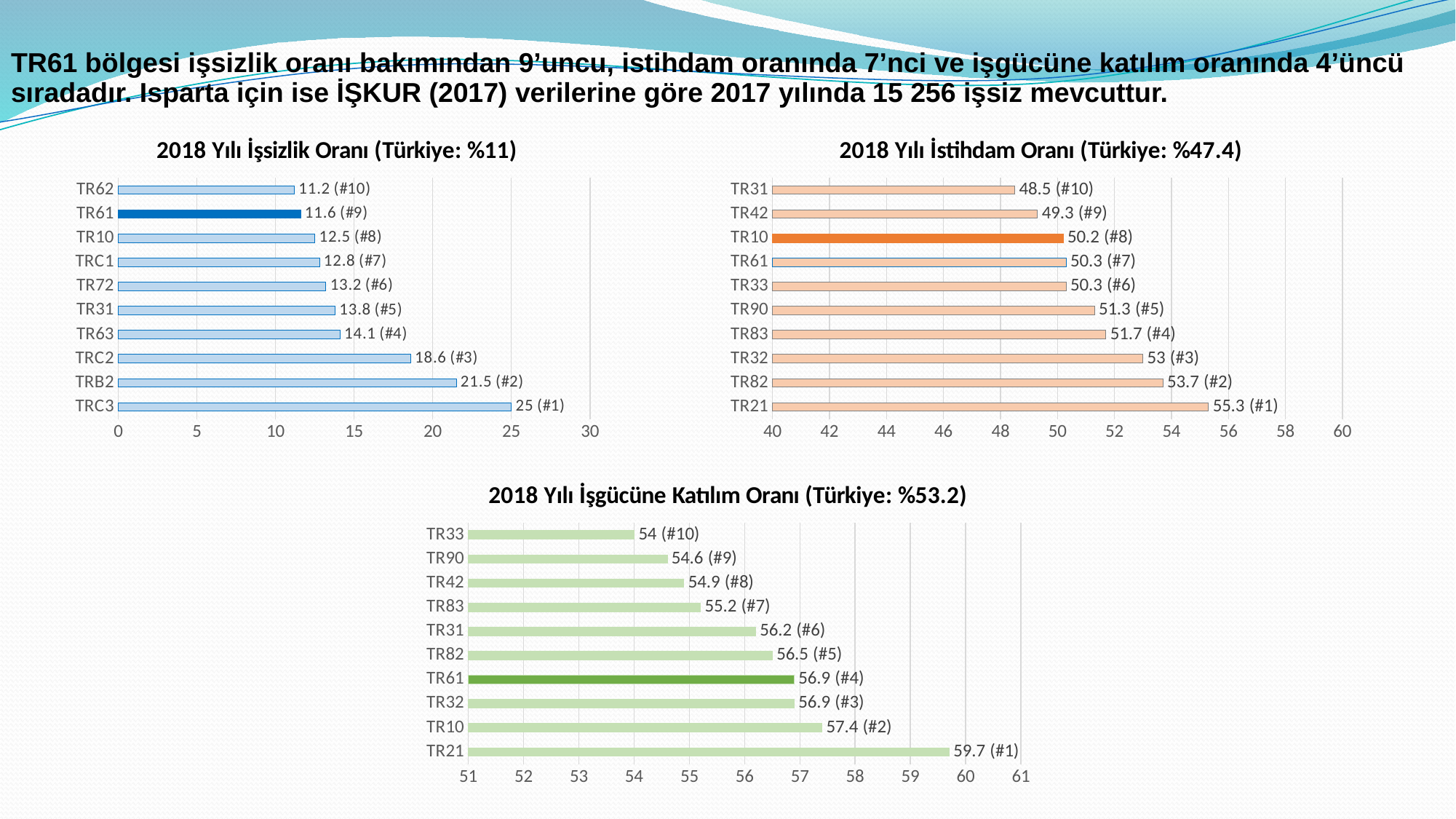
In the chart titled '2018 Yılı İstihdam Oranı (Türkiye: %47.4)', which bar is highlighted in a darker orange colour? TR10 In the chart titled '2018 Yılı İşsizlik Oranı (Türkiye: %11)', what is the value for TR61? 11.6 In the chart titled '2018 Yılı İşsizlik Oranı (Türkiye: %11)', what is the difference between the values for TRC3 and TRB2? 3.5 In the chart titled '2018 Yılı İşgücüne Katılım Oranı (Türkiye: %53.2)', what is the value for TR61? 56.9 In the chart titled '2018 Yılı İşsizlik Oranı (Türkiye: %11)', which region has the lowest value? TR62 In the chart titled '2018 Yılı İstihdam Oranı (Türkiye: %47.4)', which is larger, the value for TR82 or the value for TR90? TR82 In the chart titled '2018 Yılı İstihdam Oranı (Türkiye: %47.4)', which region has the lowest value? TR31 In the chart titled '2018 Yılı İşsizlik Oranı (Türkiye: %11)', which region has the highest value? TRC3 In the chart titled '2018 Yılı İşsizlik Oranı (Türkiye: %11)', how many regions are shown? 10 In the chart titled '2018 Yılı İstihdam Oranı (Türkiye: %47.4)', what is the value for TR21? 55.3 In the chart titled '2018 Yılı İşgücüne Katılım Oranı (Türkiye: %53.2)', what is the difference between the values for TR21 and TR33? 5.7 What type of chart is the chart titled '2018 Yılı İşgücüne Katılım Oranı (Türkiye: %53.2)'? Bar chart